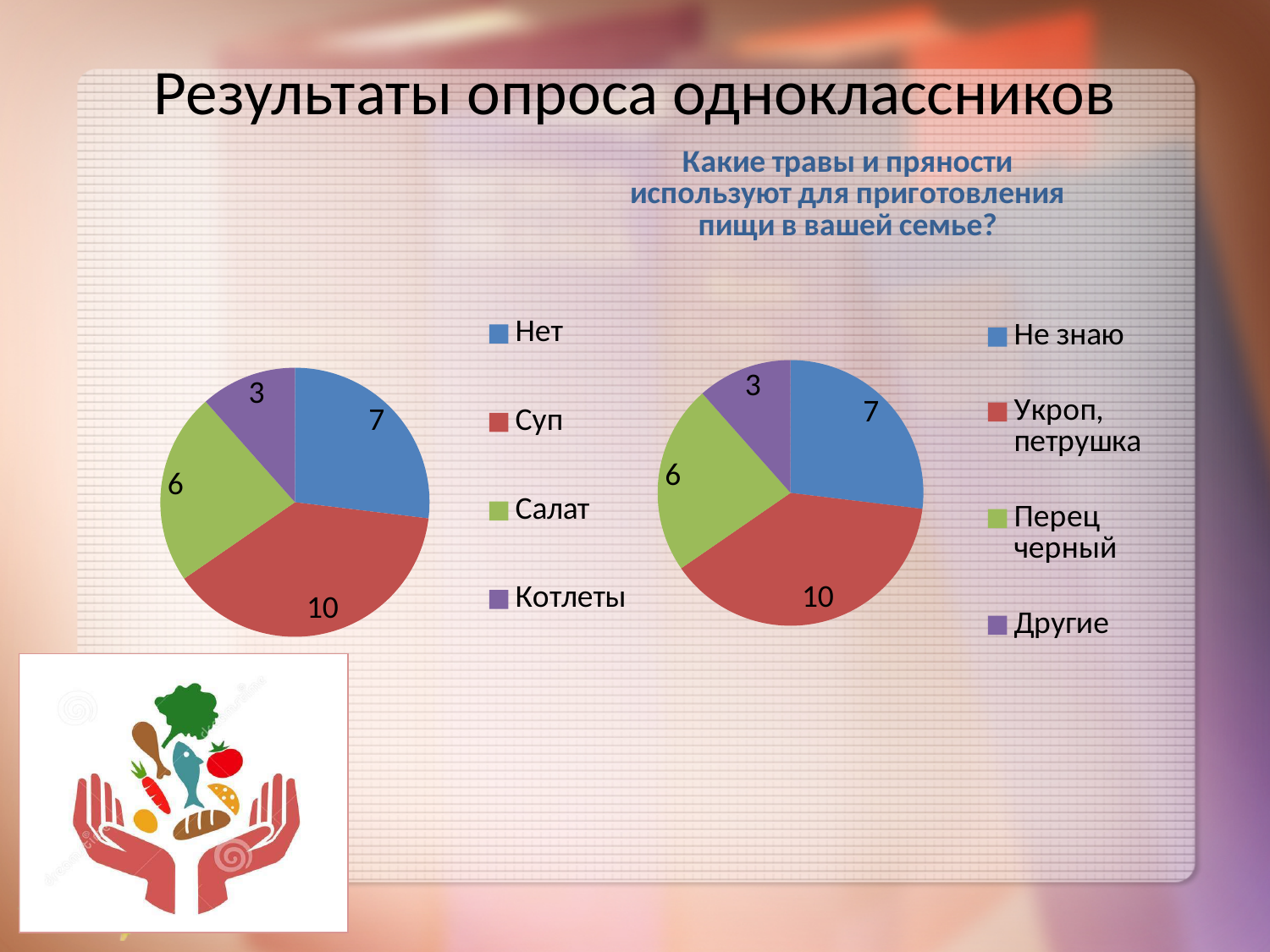
In the chart titled 'Какие травы и пряности используют для приготовления пищи в вашей семье?', which is larger: Не знаю or Другие? Не знаю In the left pie chart, which category has the smallest slice? Котлеты In the chart titled 'Какие травы и пряности используют для приготовления пищи в вашей семье?', what is the value for Перец черный? 6 In the left pie chart, what is the difference between the values for Нет and Салат? 1 What type of chart is the chart titled 'Какие травы и пряности используют для приготовления пищи в вашей семье?'? Pie chart In the left pie chart, what is the value for Котлеты? 3 In the left pie chart, which category has the largest slice? Суп How many categories does the left pie chart show? 4 In the chart titled 'Какие травы и пряности используют для приготовления пищи в вашей семье?', what is the difference between the values for Укроп, петрушка and Другие? 7 In the chart titled 'Какие травы и пряности используют для приготовления пищи в вашей семье?', which category has the smallest slice? Другие In the chart titled 'Какие травы и пряности используют для приготовления пищи в вашей семье?', what is the value for Укроп, петрушка? 10 In the left pie chart, what is the value for Суп? 10